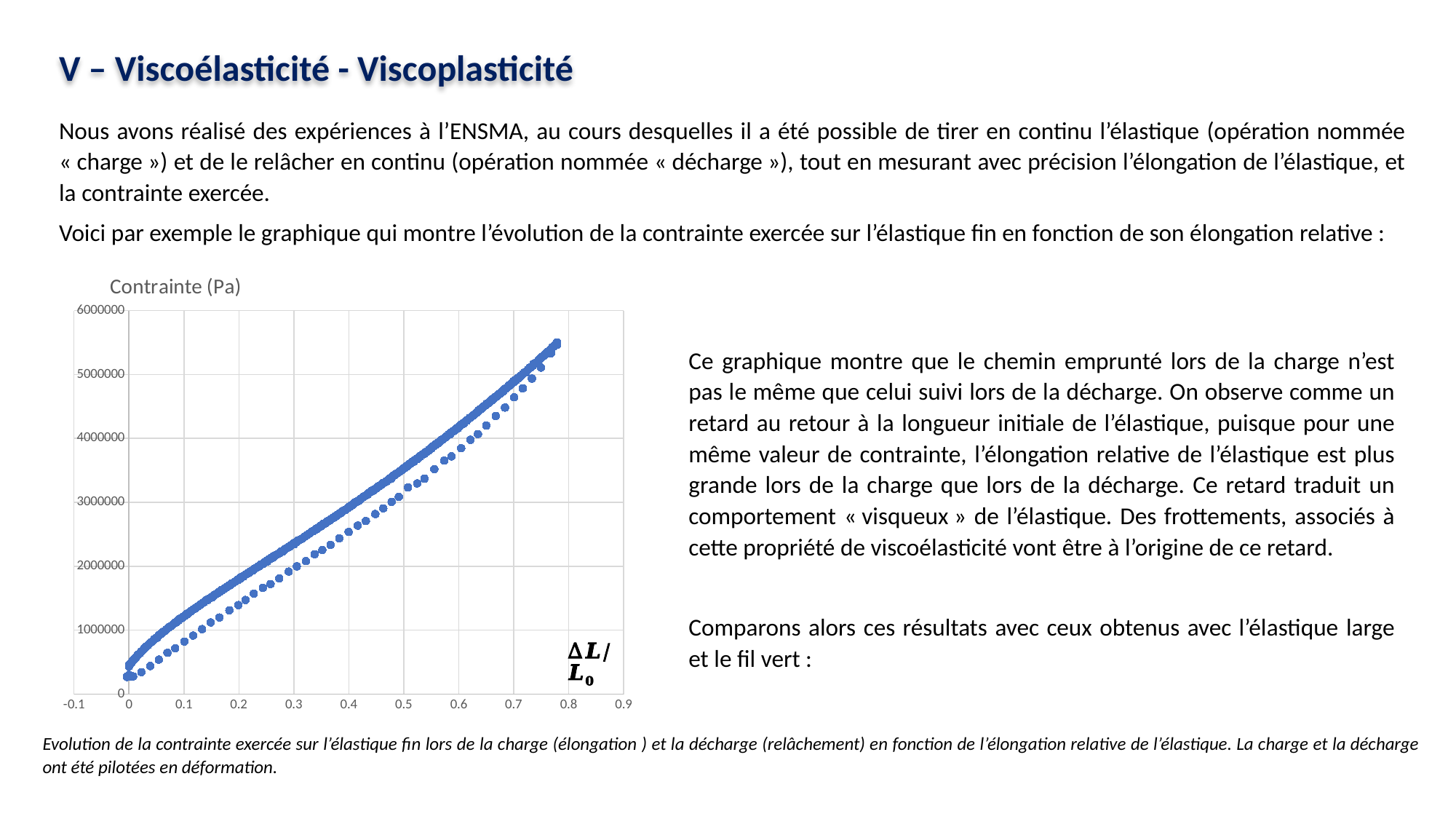
At an elongation relative of 0.2, is the contrainte value greater or less than 2000000? less Is the highest contrainte value plotted greater or less than 6000000? less Is the contrainte value at an elongation relative of 0.6 larger or smaller than the value at 0.3? larger What is the title shown above the chart's vertical axis? Contrainte (Pa) What is the lowest value shown on the chart's vertical axis? 0 What colour are the plotted points in the chart? blue Do the plotted values rise or fall as the elongation relative (x axis) increases? rise What kind of chart is shown on the slide? scatter chart Is the highest contrainte value plotted greater or less than 5000000? greater